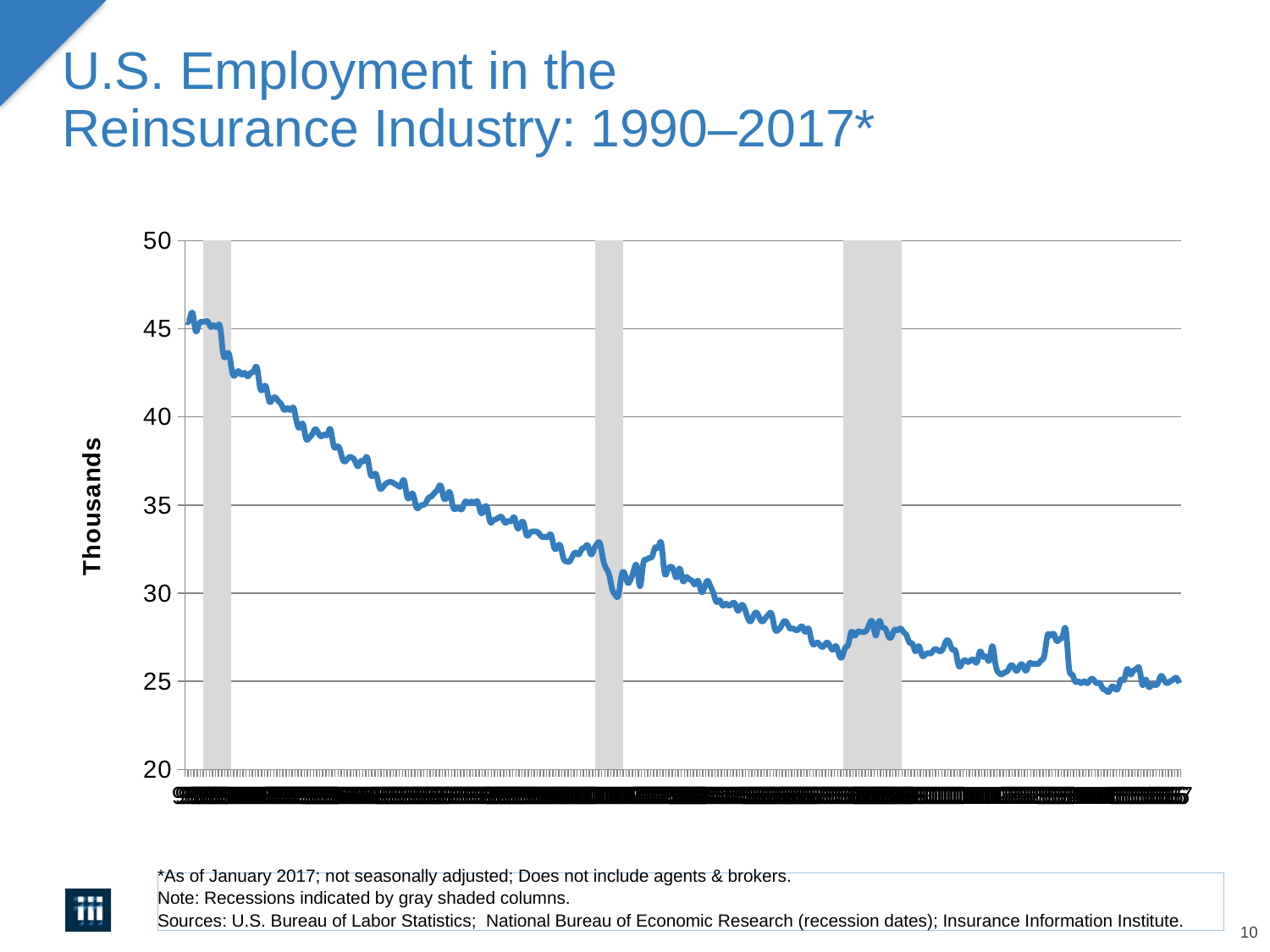
Is the value at the end of the series (right end of the line) greater or less than 30? less Overall, do the values rise or fall from left to right along the x axis? Fall Is the highest point of the line greater or less than 50? less What is the label on the vertical axis of the chart? Thousands Is the value at the end of the series (right end of the line) greater or less than 20? greater How many gray shaded recession columns are shown on the chart? 3 What kind of chart is shown on the slide? Line chart What is the title of the chart on the slide? U.S. Employment in the Reinsurance Industry: 1990–2017* What is the highest value shown on the vertical axis? 50